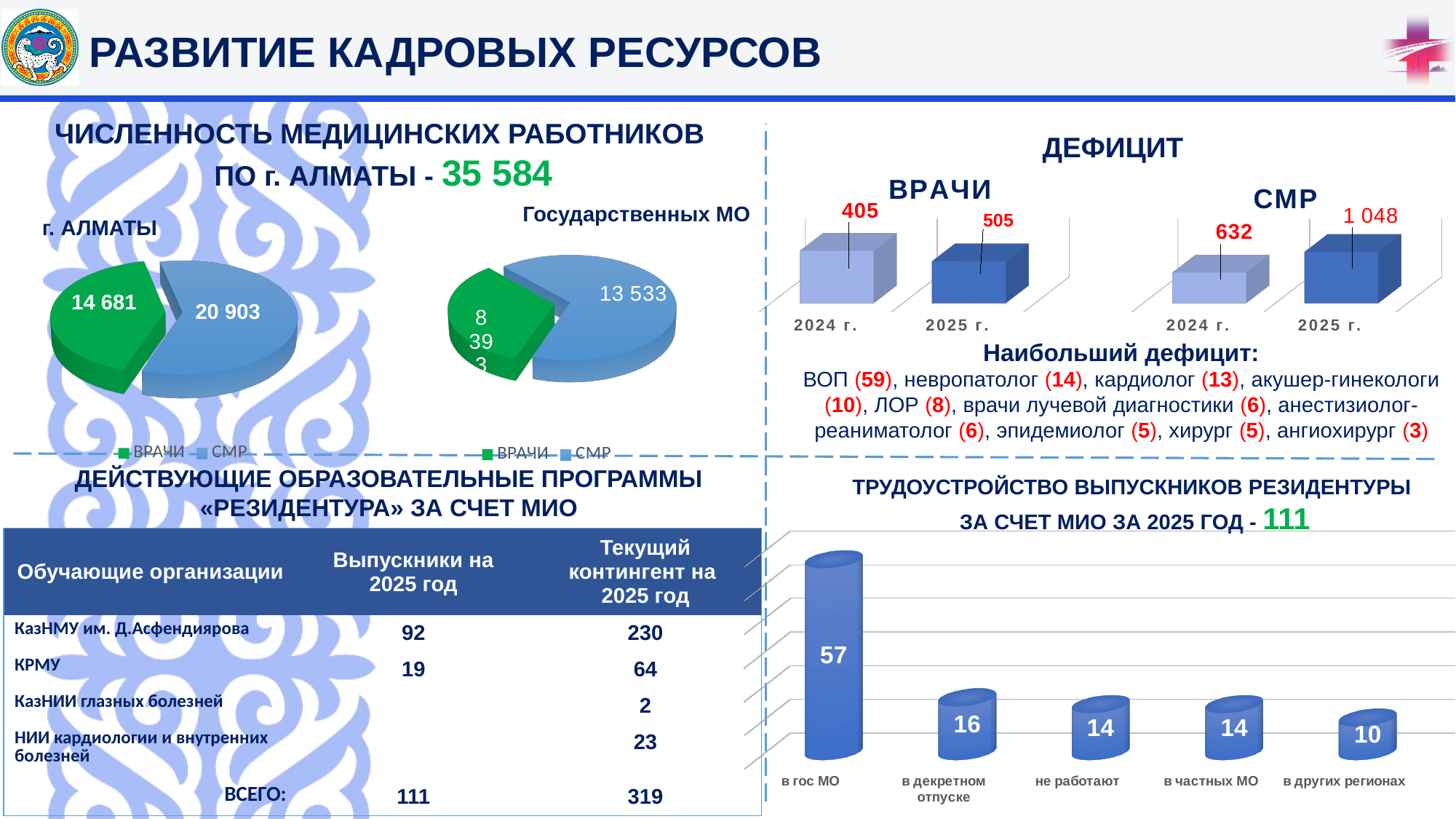
In the 'ТРУДОУСТРОЙСТВО ВЫПУСКНИКОВ РЕЗИДЕНТУРЫ' chart, what is the value for 'в декретном отпуске'? 16 In the pie chart titled 'г. АЛМАТЫ', what is the value for ВРАЧИ? 14 681 In the 'ДЕФИЦИТ' bar chart for ВРАЧИ, what is the value for 2025 г.? 505 In the 'ТРУДОУСТРОЙСТВО ВЫПУСКНИКОВ РЕЗИДЕНТУРЫ' chart, which category has the lowest value? в других регионах In the pie chart titled 'г. АЛМАТЫ', what is the value for СМР? 20 903 In the 'ДЕФИЦИТ' bar chart for СМР, do the values rise or fall from 2024 г. to 2025 г.? rise In the 'ДЕФИЦИТ' bar chart for ВРАЧИ, what is the difference between the 2025 г. and 2024 г. values? 100 How many categories are shown in the 'ТРУДОУСТРОЙСТВО ВЫПУСКНИКОВ РЕЗИДЕНТУРЫ' bar chart? 5 In the pie chart titled 'Государственных МО', what is the value for СМР? 13 533 In the 'ДЕФИЦИТ' bar chart for СМР, what is the value for 2025 г.? 1 048 In the 'ТРУДОУСТРОЙСТВО ВЫПУСКНИКОВ РЕЗИДЕНТУРЫ' chart, which category has the highest value? в гос МО In the pie chart titled 'г. АЛМАТЫ', which slice is larger, ВРАЧИ or СМР? СМР